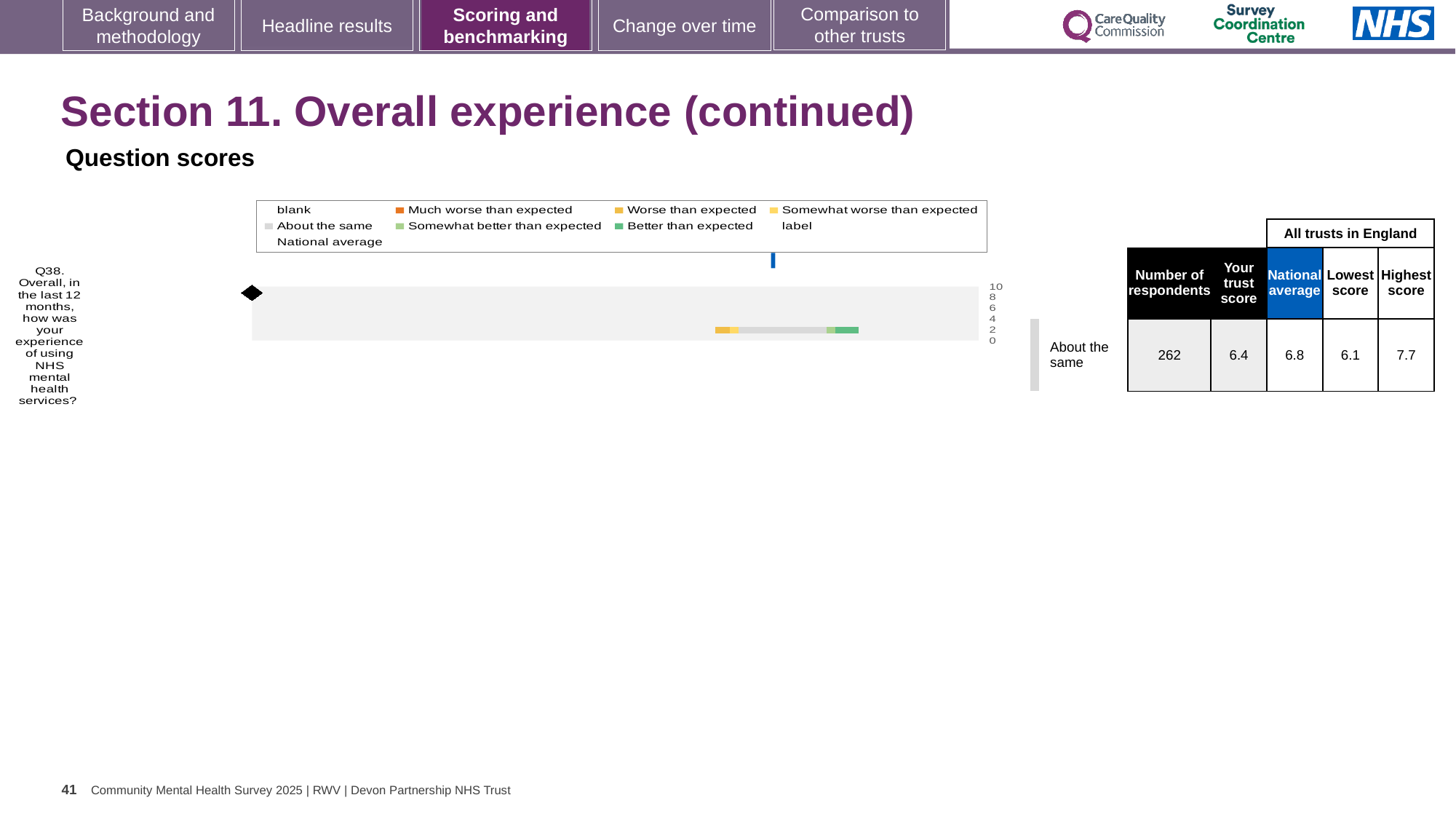
How many respondents answered Q38? 262 Which legend entry is shown in dark green? Better than expected What benchmark category is Q38 assigned to, according to the label next to the chart? About the same What is the difference between the highest and lowest scores among all trusts in England for Q38? 1.6 What kind of chart is used to show the Q38 question score? bar chart What is the highest score among all trusts in England for Q38? 7.7 What is the national average score for Q38? 6.8 What is the lowest score among all trusts in England for Q38? 6.1 How many survey questions are plotted in the chart? 1 What is the trust's score for Q38? 6.4 Which is larger for Q38, the trust score or the national average? National average Which survey question is plotted in the chart? Q38. Overall, in the last 12 months, how was your experience of using NHS mental health services?